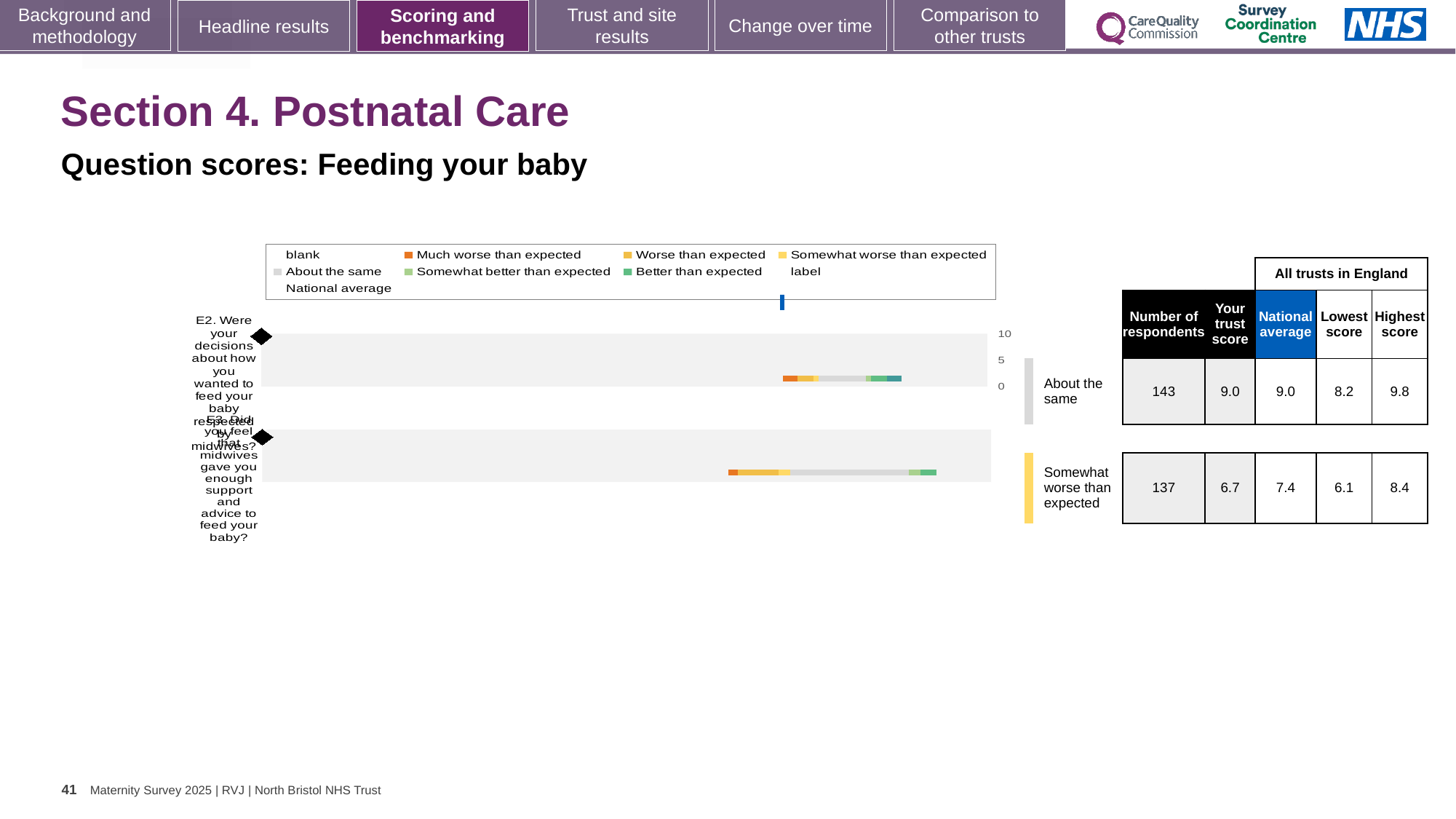
In the chart legend, which colour represents 'Much worse than expected'? orange According to the table beside the chart, what is the trust score for E2 (decisions about how you wanted to feed your baby respected by midwives)? 9.0 Which question has the higher trust score, E2 or E3? E2 Is the trust score for E3 greater or less than 5 on the chart's axis? greater In the chart legend, which colour represents 'Better than expected'? green What is the difference between the trust score and the national average for E3? 0.7 What kind of chart is shown on the slide? bar chart What is the difference between the highest score and the lowest score for E2 across all trusts in England? 1.6 According to the table beside the chart, what is the national average for E3? 7.4 According to the table beside the chart, how many respondents answered E2? 143 How many questions (categories) are plotted in the chart? 2 According to the table beside the chart, what is the trust score for E3 (midwives gave you enough support and advice to feed your baby)? 6.7